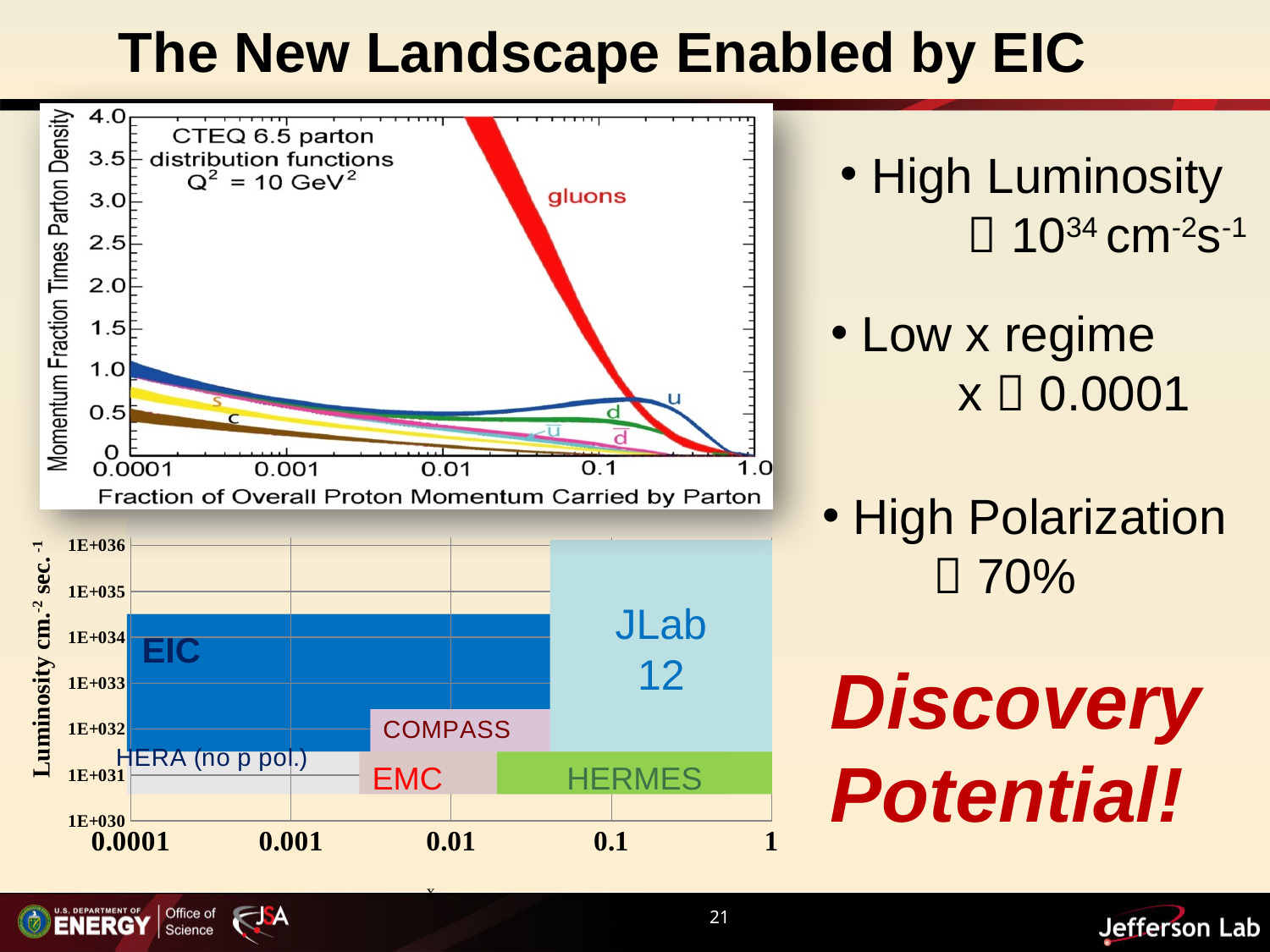
In the bottom chart, is the top of the HERMES region greater or less than 1E+032? less In the bottom chart, which region reaches a higher luminosity, COMPASS or EMC? COMPASS In the top chart, which labeled curve has the highest value at x = 0.01? gluons In the top chart, how many labeled parton curves are shown? 7 In the top chart, what is the label of the x axis? Fraction of Overall Proton Momentum Carried by Parton In the top chart, what is the maximum value shown on the y axis? 4.0 In the bottom chart, how many labeled experiment regions are shown? 6 In the bottom chart, what is the smallest x value shown on the x axis? 0.0001 In the bottom chart, which labeled experiment region reaches the highest luminosity? JLab 12 In the top chart, does the gluons curve rise or fall as x increases from 0.01 to 0.1? fall In the bottom chart, is the top of the EIC region greater or less than 1E+033? greater